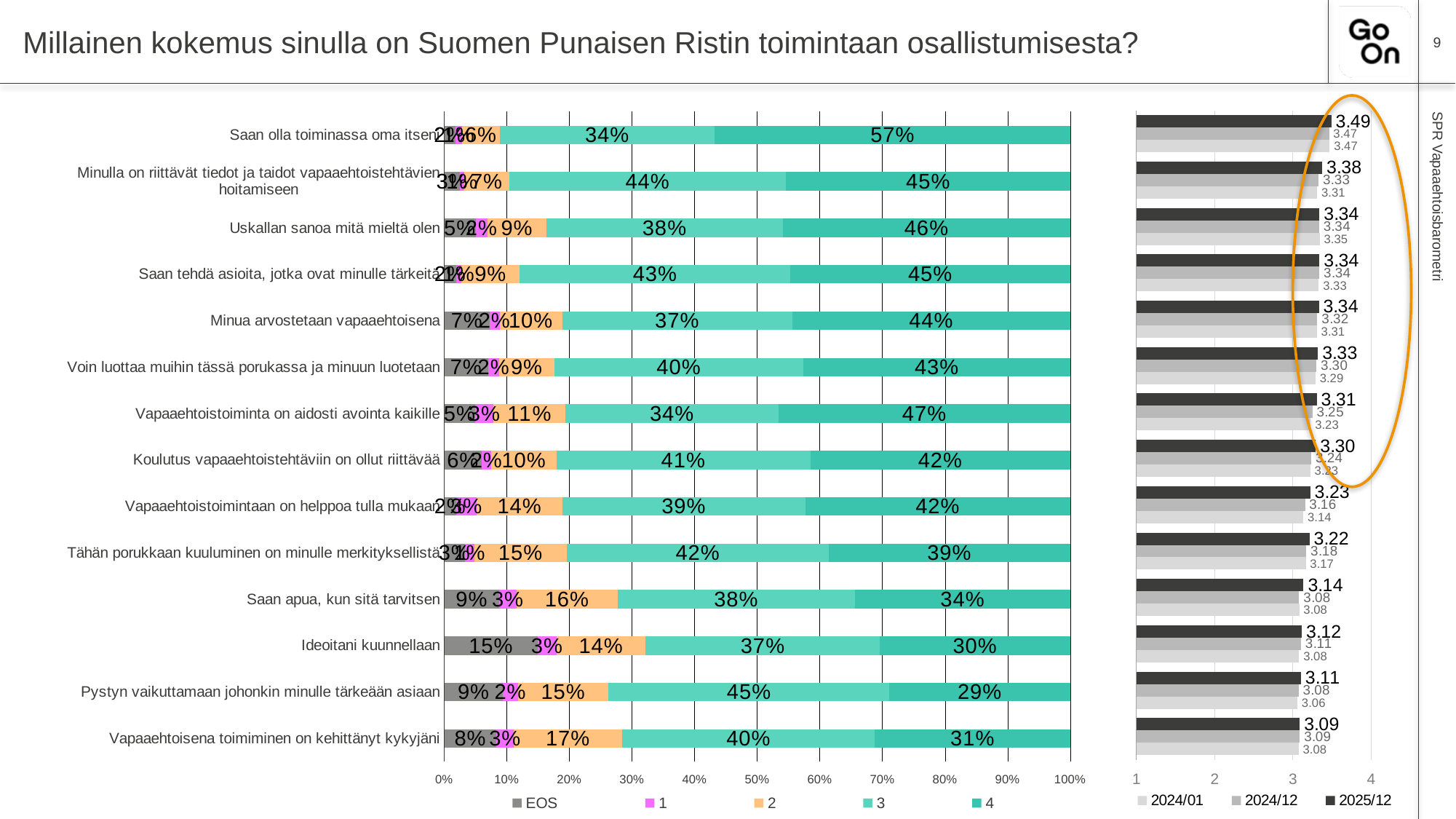
In the left stacked bar chart, which statement has the lowest share of rating 4? Pystyn vaikuttamaan johonkin minulle tärkeään asiaan How many series does the legend of the right chart list? 3 In the left stacked bar chart, what is the difference in percentage points between the rating 3 share and the rating 4 share for "Saan apua, kun sitä tarvitsen"? 4 percentage points What type of chart is the left chart on the slide? Stacked bar chart In the right chart, what is the 2025/12 value for "Saan olla toiminnassa oma itseni"? 3.49 In the left stacked bar chart, for "Ideoitani kuunnellaan", which is larger: the share of rating 3 or the share of rating 4? Rating 3 In the left stacked bar chart, what percentage of respondents gave a rating of 4 for "Saan olla toiminnassa oma itseni"? 57% How many statements are listed in the left stacked bar chart? 14 In the left stacked bar chart, which statement has the highest share of rating 4? Saan olla toiminnassa oma itseni How many series does the legend of the left stacked bar chart list? 5 In the left stacked bar chart, what is the EOS share for "Ideoitani kuunnellaan"? 15% In the right chart, what is the difference between the 2025/12 value and the 2024/12 value for "Saan olla toiminnassa oma itseni"? 0.02